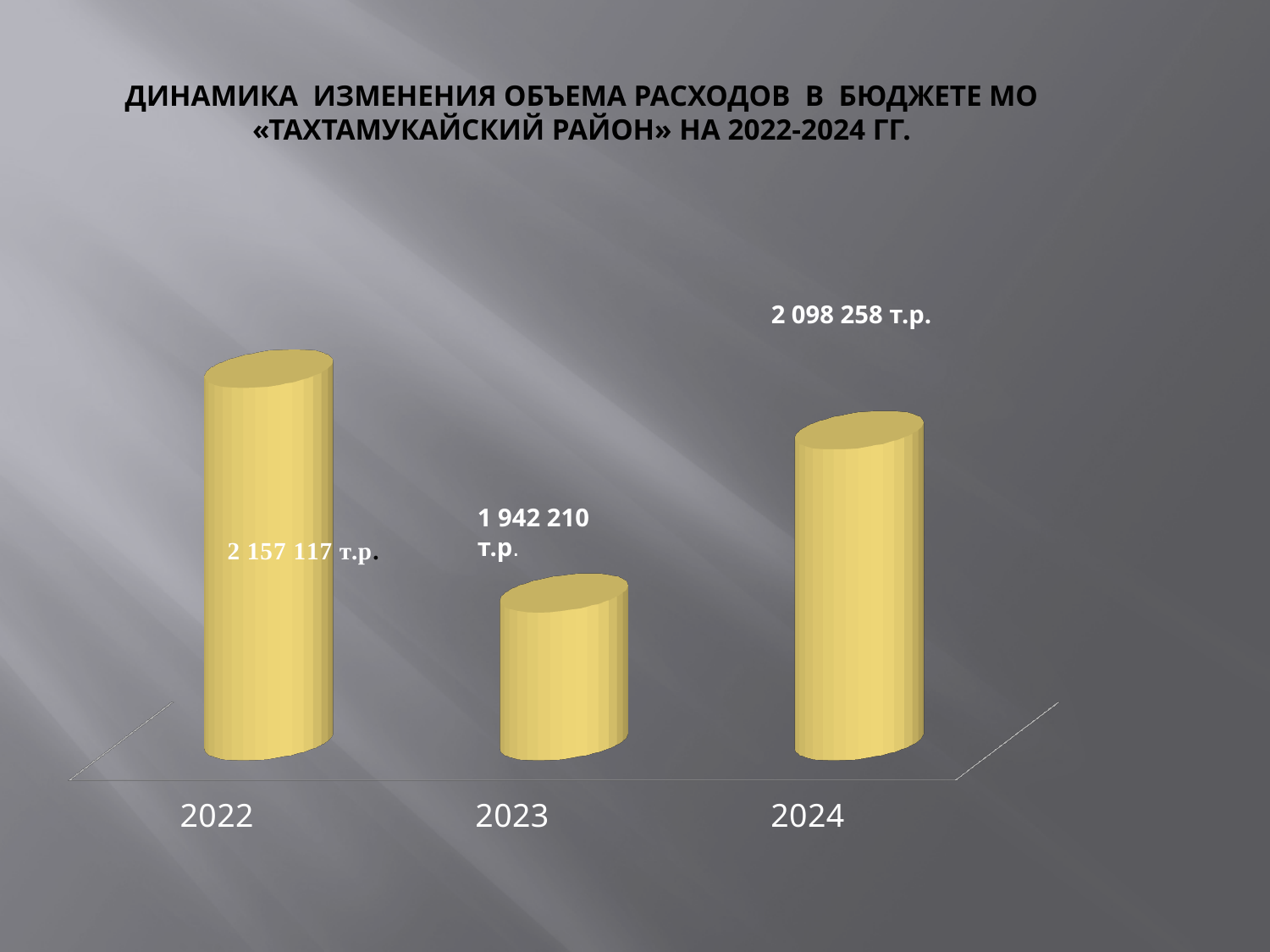
What is the difference between the values for 2024 and 2023? 156 048 т.р. Which is larger, the value for 2022 or the value for 2024? 2022 Which year has the highest expenditure value? 2022 What is the difference between the values for 2022 and 2024? 58 859 т.р. How do the values change from 2022 to 2024? They fall from 2022 to 2023, then rise in 2024 What is the value shown for 2024? 2 098 258 т.р. What is the value shown for 2022? 2 157 117 т.р. What is the difference between the values for 2022 and 2023? 214 907 т.р. How many years are shown on the chart? 3 Which year has the lowest expenditure value? 2023 What is the value shown for 2023? 1 942 210 т.р. What kind of chart is shown on the slide? Bar chart